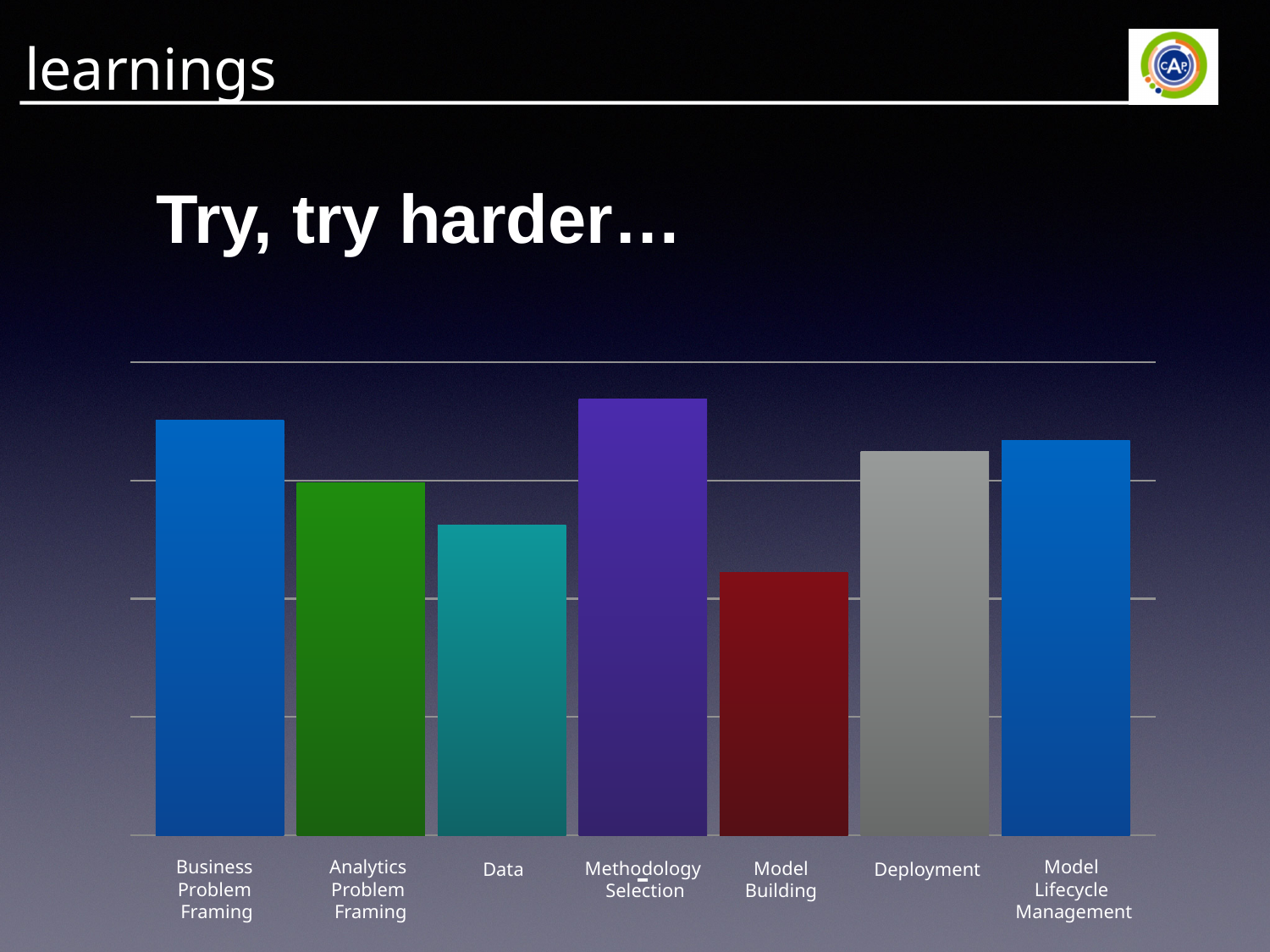
Which is larger, the value for Data or the value for Deployment? Deployment Which category has the highest bar? Methodology Selection Which is larger, the value for Analytics Problem Framing or the value for Data? Analytics Problem Framing What colour is the bar for Model Building? red Which is larger, the value for Methodology Selection or the value for Model Lifecycle Management? Methodology Selection How many categories are shown on the x axis of the chart? 7 What kind of chart is shown on the slide? bar chart Which category has the lowest bar? Model Building What is the label of the first category on the x axis? Business Problem Framing